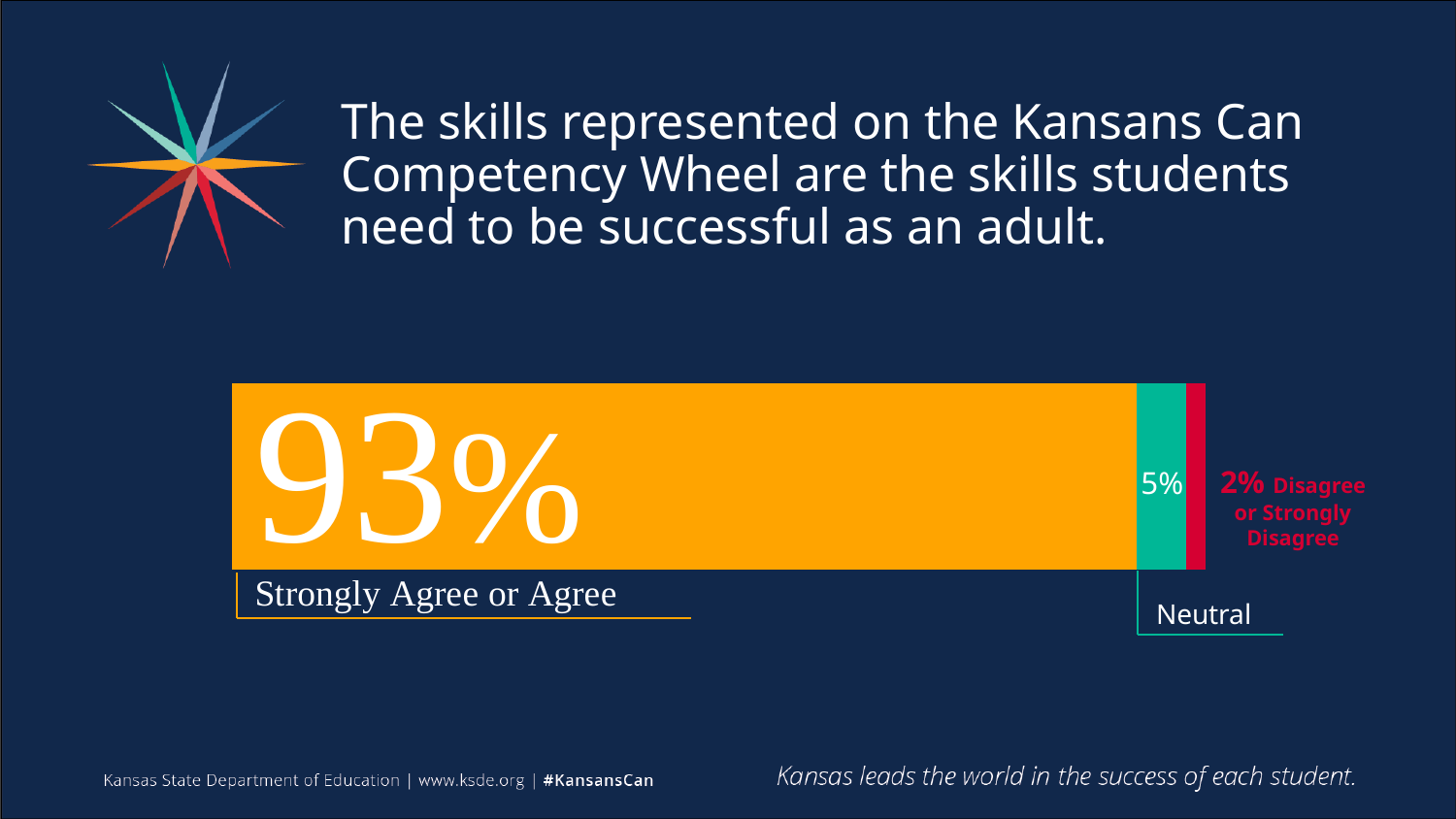
What is the difference in percentage points between Strongly Agree or Agree and Neutral? 88 What kind of chart is shown on the slide? Stacked bar chart Which response category has the largest share? Strongly Agree or Agree What is the total of the three segments in the bar? 100% Which is larger, the Neutral share or the Disagree or Strongly Disagree share? Neutral What percentage of respondents Strongly Agree or Agree that the skills on the Kansans Can Competency Wheel are the skills students need to be successful as an adult? 93% What percentage of respondents are Neutral? 5% What percentage of respondents Disagree or Strongly Disagree? 2% What colour is the Neutral segment of the bar? Green Which response category has the smallest share? Disagree or Strongly Disagree How many response categories are shown in the bar? 3 What is the difference in percentage points between Neutral and Disagree or Strongly Disagree? 3